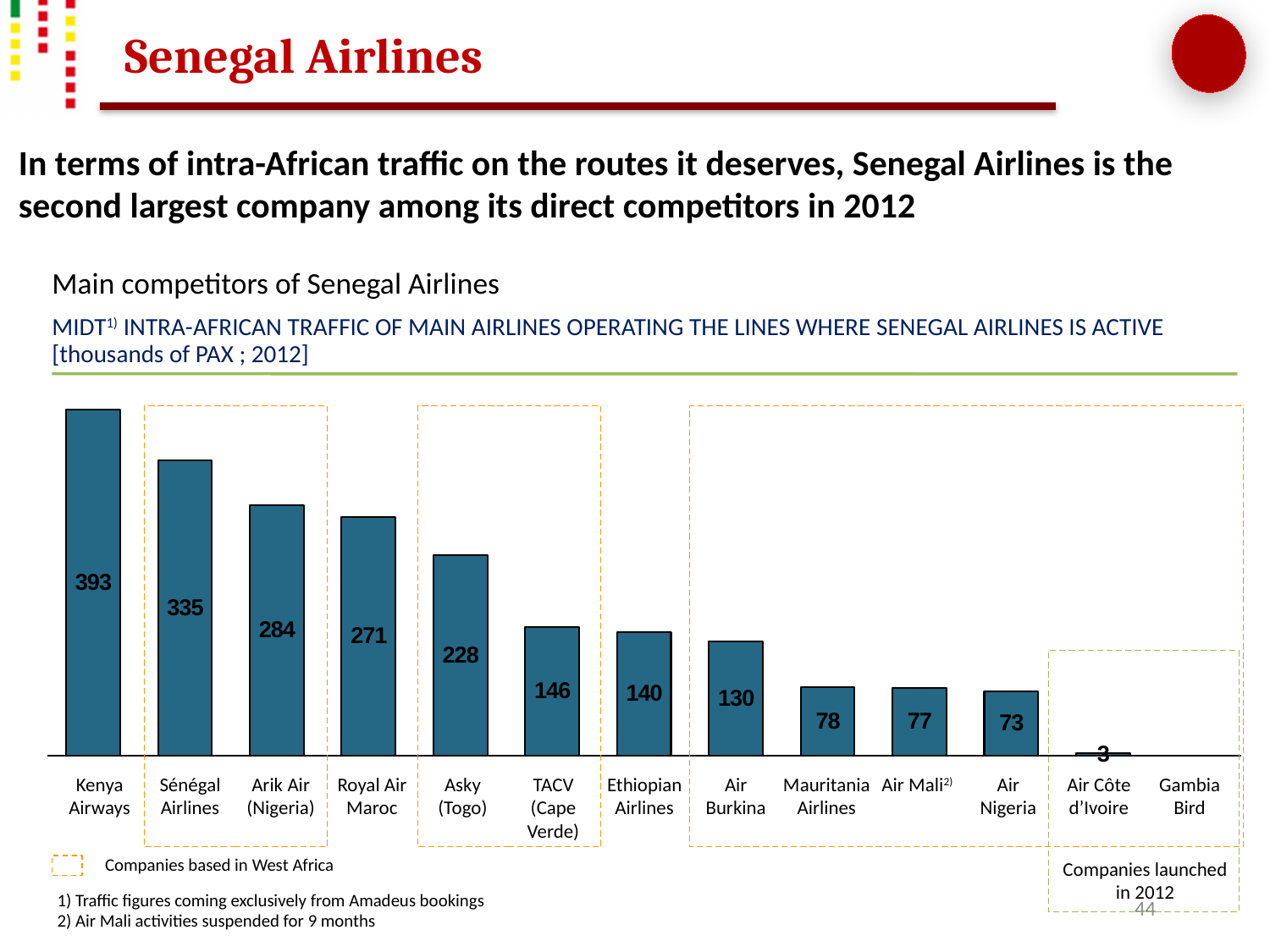
What is the value for Sénégal Airlines? 335 What is the difference between the values for Kenya Airways and Sénégal Airlines? 58 What is the difference between the values for Arik Air (Nigeria) and Royal Air Maroc? 13 Which is larger, the value for Air Burkina or the value for Mauritania Airlines? Air Burkina Do the values rise or fall from left to right across the airlines? Fall Which airline has the highest value? Kenya Airways What unit are the values in, according to the chart subtitle? Thousands of PAX What is the value for Kenya Airways? 393 What is the value for Air Mali? 77 What kind of chart is shown on the slide? Bar chart What is the value for Asky (Togo)? 228 Which is larger, the value for TACV (Cape Verde) or the value for Ethiopian Airlines? TACV (Cape Verde)